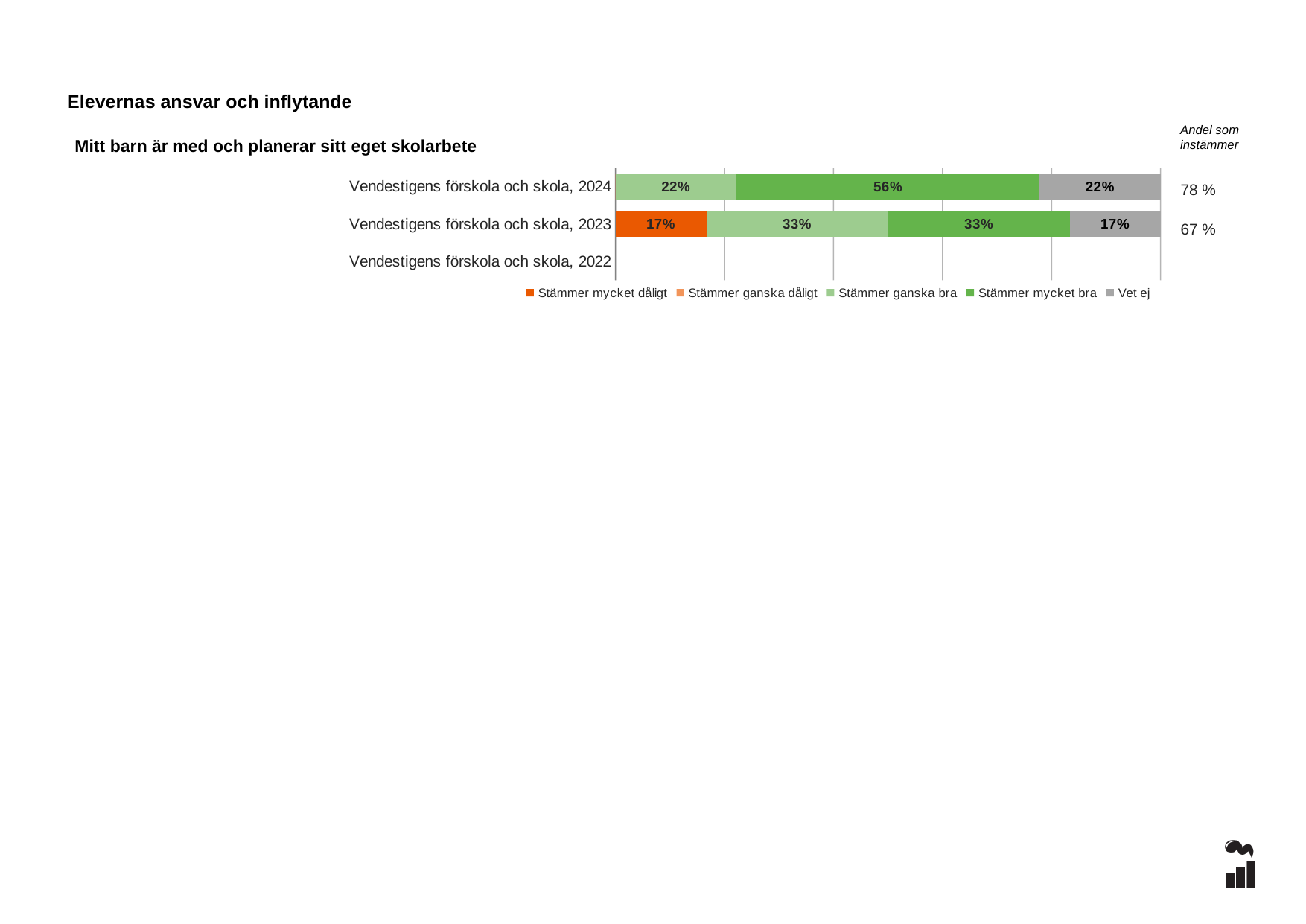
What is the title of the chart? Mitt barn är med och planerar sitt eget skolarbete How many category rows are shown on the chart? 3 What is the value for "Vet ej" for Vendestigens förskola och skola, 2023? 17% What is the value for "Stämmer ganska bra" for Vendestigens förskola och skola, 2024? 22% How many series does the legend list? 5 What is the "Andel som instämmer" value shown for Vendestigens förskola och skola, 2024? 78 % What is the value for "Stämmer mycket dåligt" for Vendestigens förskola och skola, 2023? 17% Which year has the larger "Vet ej" value, 2024 or 2023? 2024 What is the difference between the "Stämmer mycket bra" values for 2024 and 2023? 23% What kind of chart is shown on the slide? Stacked bar chart What is the "Andel som instämmer" value shown for Vendestigens förskola och skola, 2023? 67 % What is the value for "Stämmer mycket bra" for Vendestigens förskola och skola, 2024? 56%